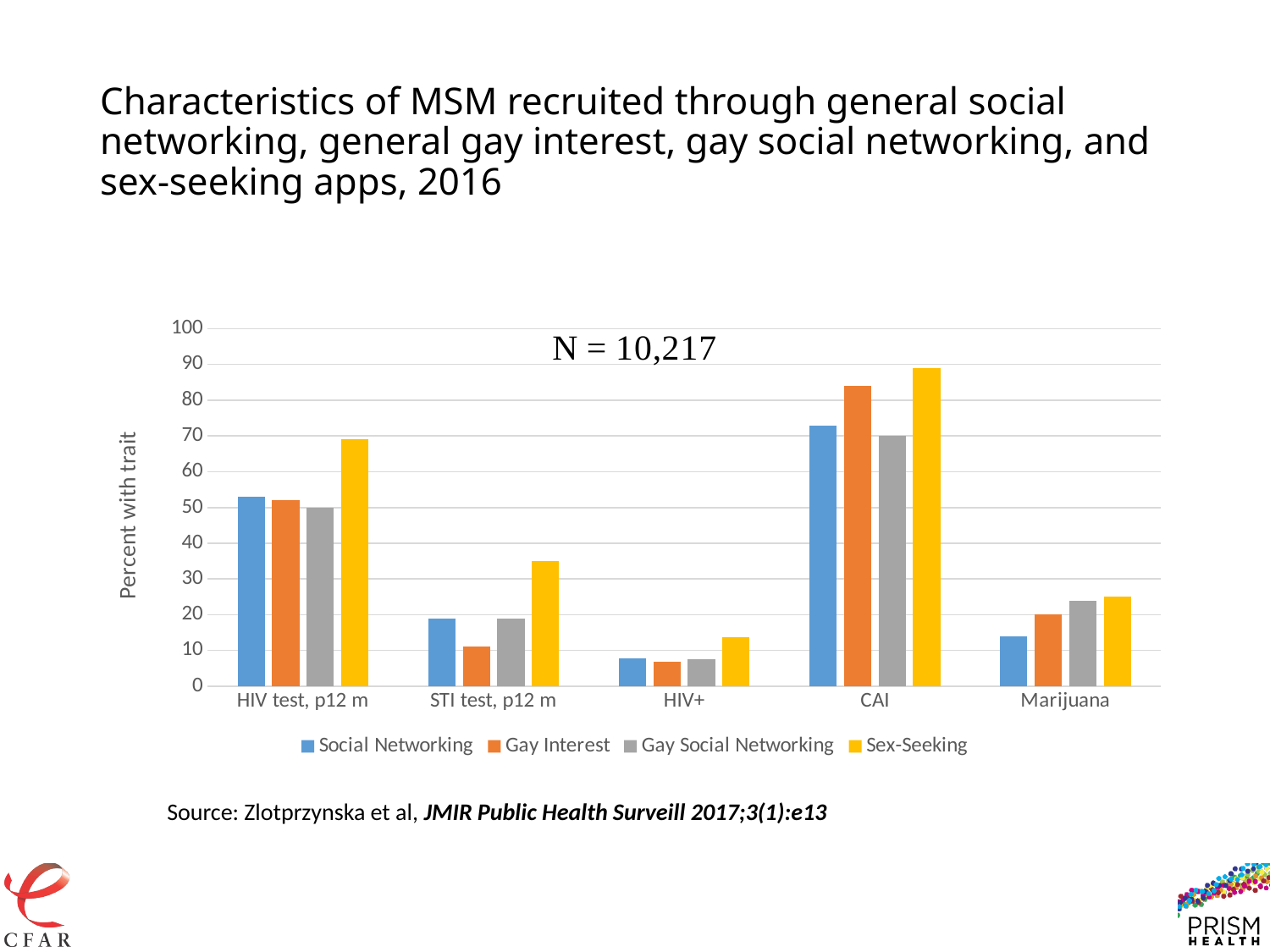
For the Sex-Seeking series, which category has the highest value? CAI For the Social Networking series, which category has the lowest value? HIV+ Is the Sex-Seeking value for CAI greater or less than 80? greater In the CAI category, which series has the highest bar? Sex-Seeking What sample size (N) is printed on the chart? N = 10,217 For Marijuana, which is larger: the Social Networking value or the Gay Social Networking value? Gay Social Networking How many categories are shown along the x axis of the chart? 5 Is the Sex-Seeking value for STI test, p12 m greater or less than 30? greater Is the Gay Interest value for STI test, p12 m greater or less than 20? less What kind of chart is shown on the slide? Bar chart For HIV test, p12 m, which is larger: the Sex-Seeking value or the Social Networking value? Sex-Seeking How many series does the chart's legend list? 4